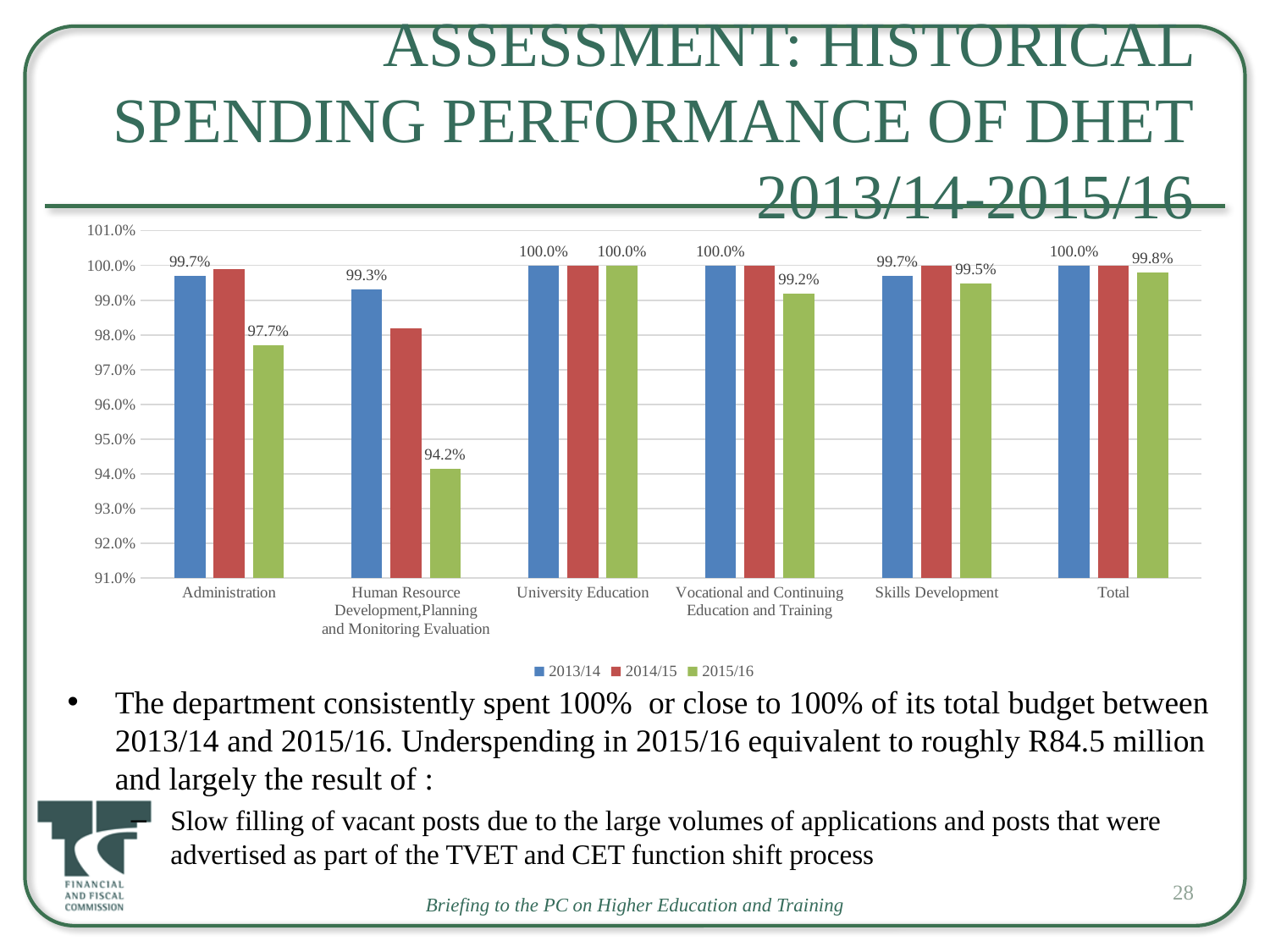
How many categories are shown on the x axis? 6 How many series does the legend list? 3 What kind of chart is shown on the slide? Bar chart What was the 2015/16 value for Human Resource Development, Planning and Monitoring Evaluation? 94.2% Which category had the lowest 2015/16 value? Human Resource Development, Planning and Monitoring Evaluation Is the 2014/15 value for Human Resource Development, Planning and Monitoring Evaluation greater or less than 99.0%? less What was the spending performance for Administration in 2015/16? 97.7% What was the Total spending performance in 2015/16? 99.8% What was the spending performance for Administration in 2013/14? 99.7% What was the 2015/16 value for Vocational and Continuing Education and Training? 99.2% What is the difference between the 2013/14 and 2015/16 values for Human Resource Development, Planning and Monitoring Evaluation? 5.1% Which is larger for Skills Development: the 2013/14 value or the 2015/16 value? 2013/14